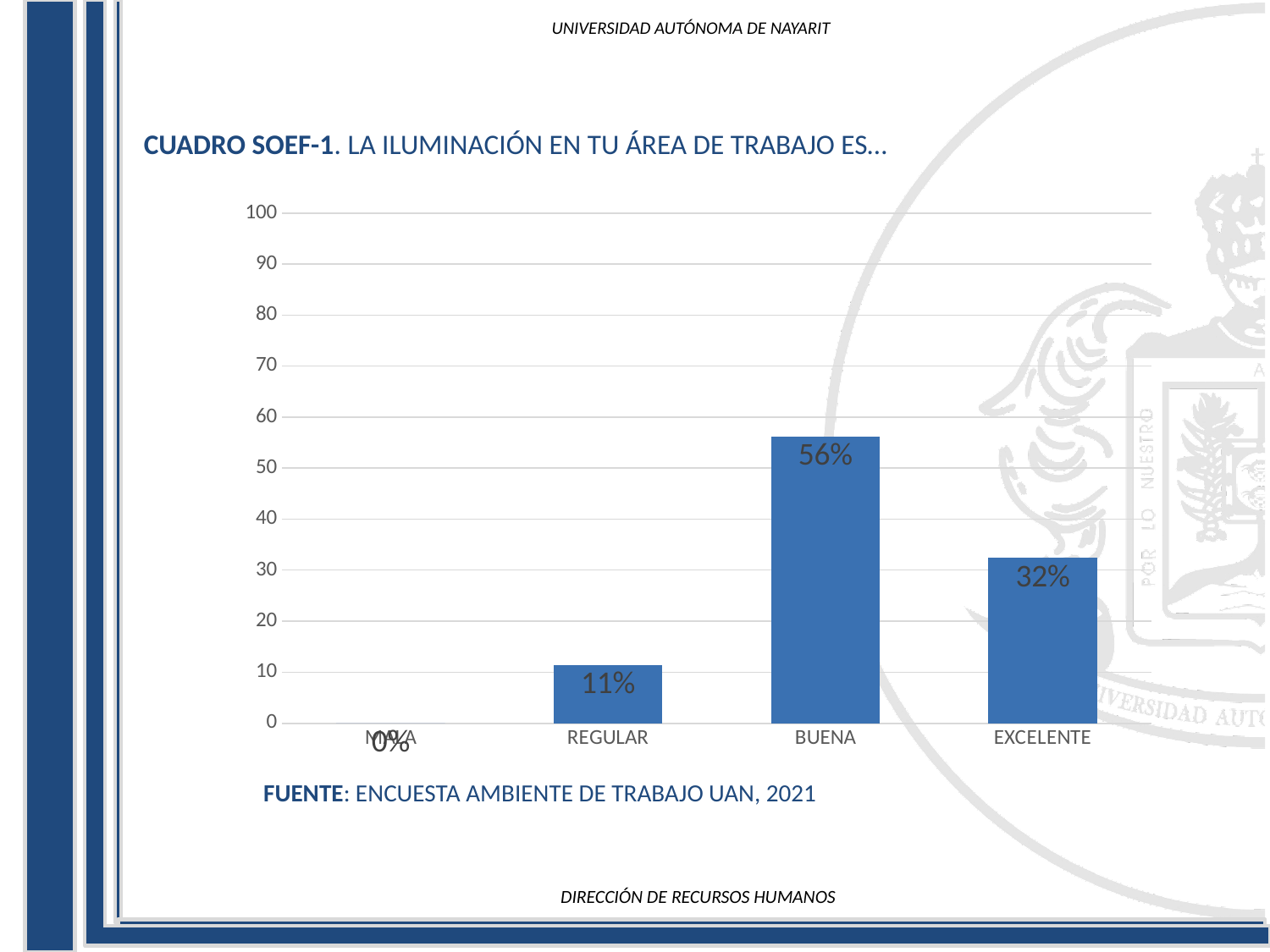
What is the source cited below the chart? ENCUESTA AMBIENTE DE TRABAJO UAN, 2021 What is the value for BUENA? 56% Which category has the highest value? BUENA What is the value for REGULAR? 11% What type of chart is shown on the slide? bar chart Which is larger, the value for REGULAR or the value for EXCELENTE? EXCELENTE What is the difference between the values for EXCELENTE and REGULAR? 21% How many categories are shown on the x axis? 4 What is the value for EXCELENTE? 32% Is the value for REGULAR greater or less than 20? less Is the value for BUENA greater or less than 50? greater What is the difference between the values for BUENA and EXCELENTE? 24%